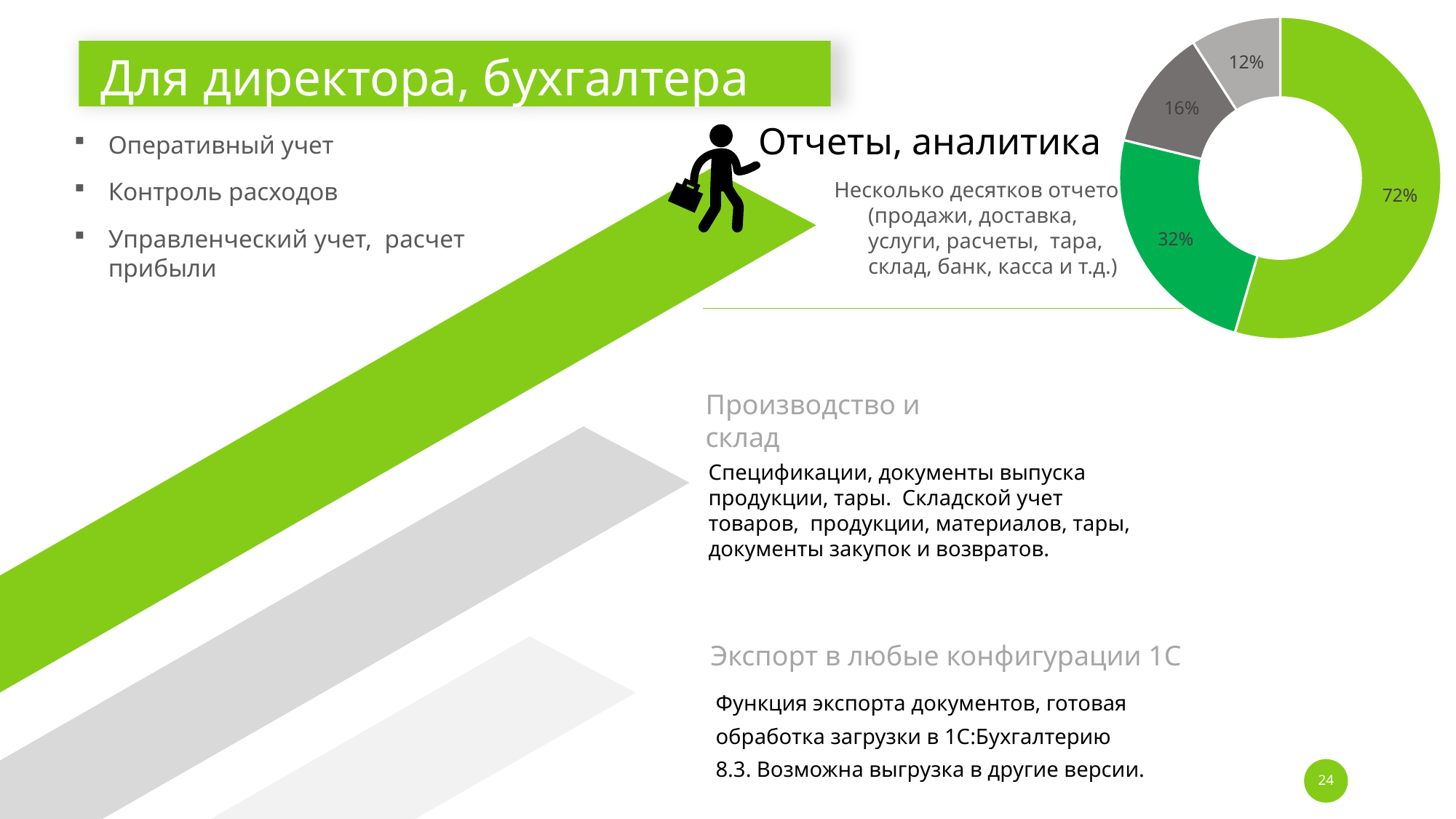
Which slice of the doughnut chart is larger, the dark grey one or the light grey one? The dark grey one (16%) How many slices does the doughnut chart have? 4 By how many percentage points does the 72% slice exceed the 32% slice in the doughnut chart? 40 What value is labelled on the light grey slice of the doughnut chart? 12% What value is labelled on the dark grey slice of the doughnut chart? 16% Does the doughnut chart have a legend naming its slices? No What value is labelled on the bright green slice of the doughnut chart? 32% What is the smallest percentage labelled on the doughnut chart? 12% By how many percentage points does the dark grey slice exceed the light grey slice in the doughnut chart? 4 What is the largest percentage labelled on the doughnut chart? 72% What value is labelled on the light green slice of the doughnut chart? 72% What kind of chart is shown in the top-right corner of the slide? Doughnut (pie) chart